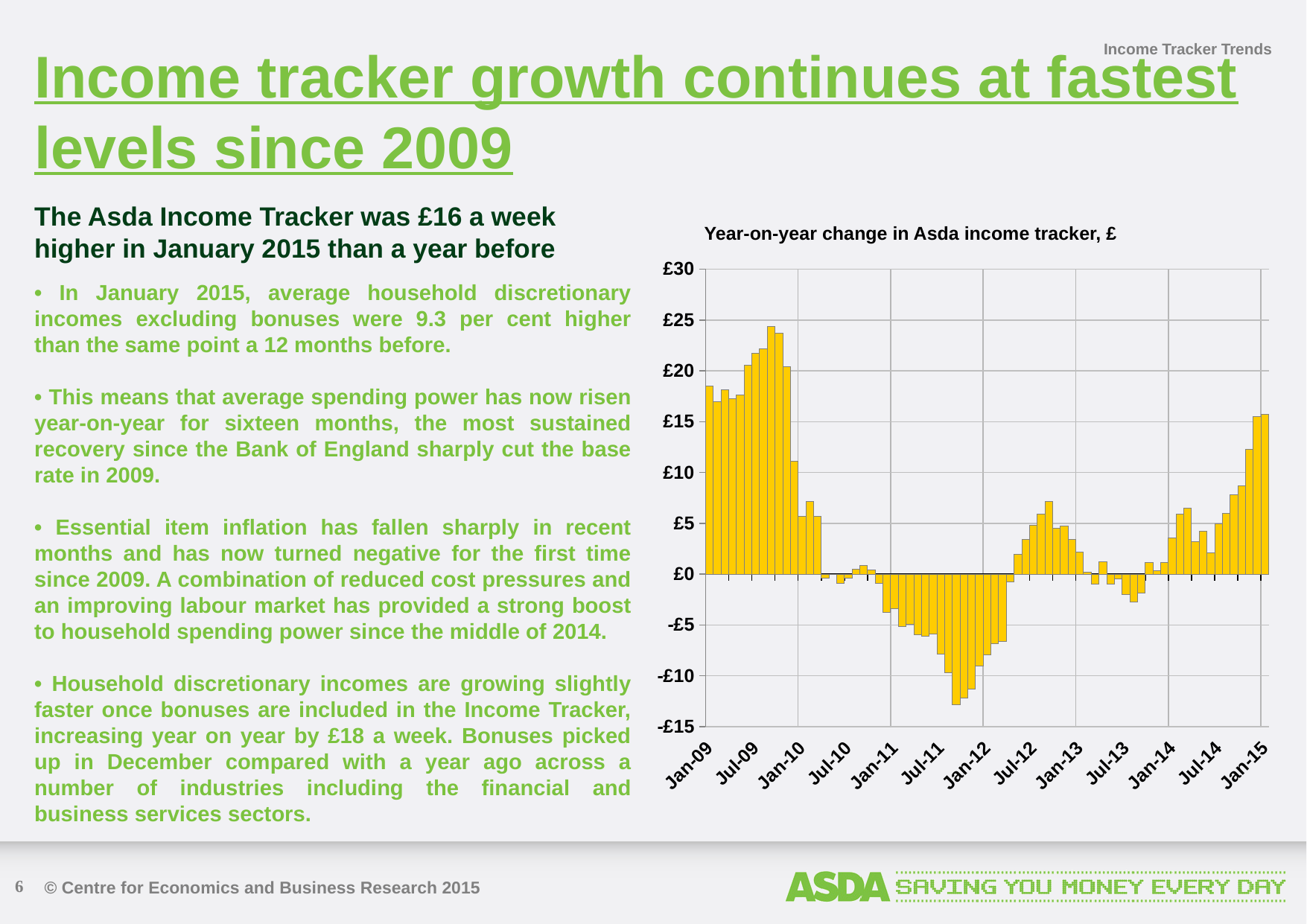
How many labelled dates are shown on the x axis of the chart? 13 Is the value for Jul-11 greater or less than £0? less Is the value for Jan-15 greater or less than £10? greater Which is larger, the value for Jan-14 or the value for Jan-15? Jan-15 Is the value for Jan-11 greater or less than £0? less Do the values rise or fall between Jul-14 and Jan-15? rise What is the highest value shown on the y axis of the chart? £30 Which is larger, the value for Jan-09 or the value for Jan-15? Jan-09 What kind of chart is shown on the slide? Bar chart What is the title of the chart? Year-on-year change in Asda income tracker, £